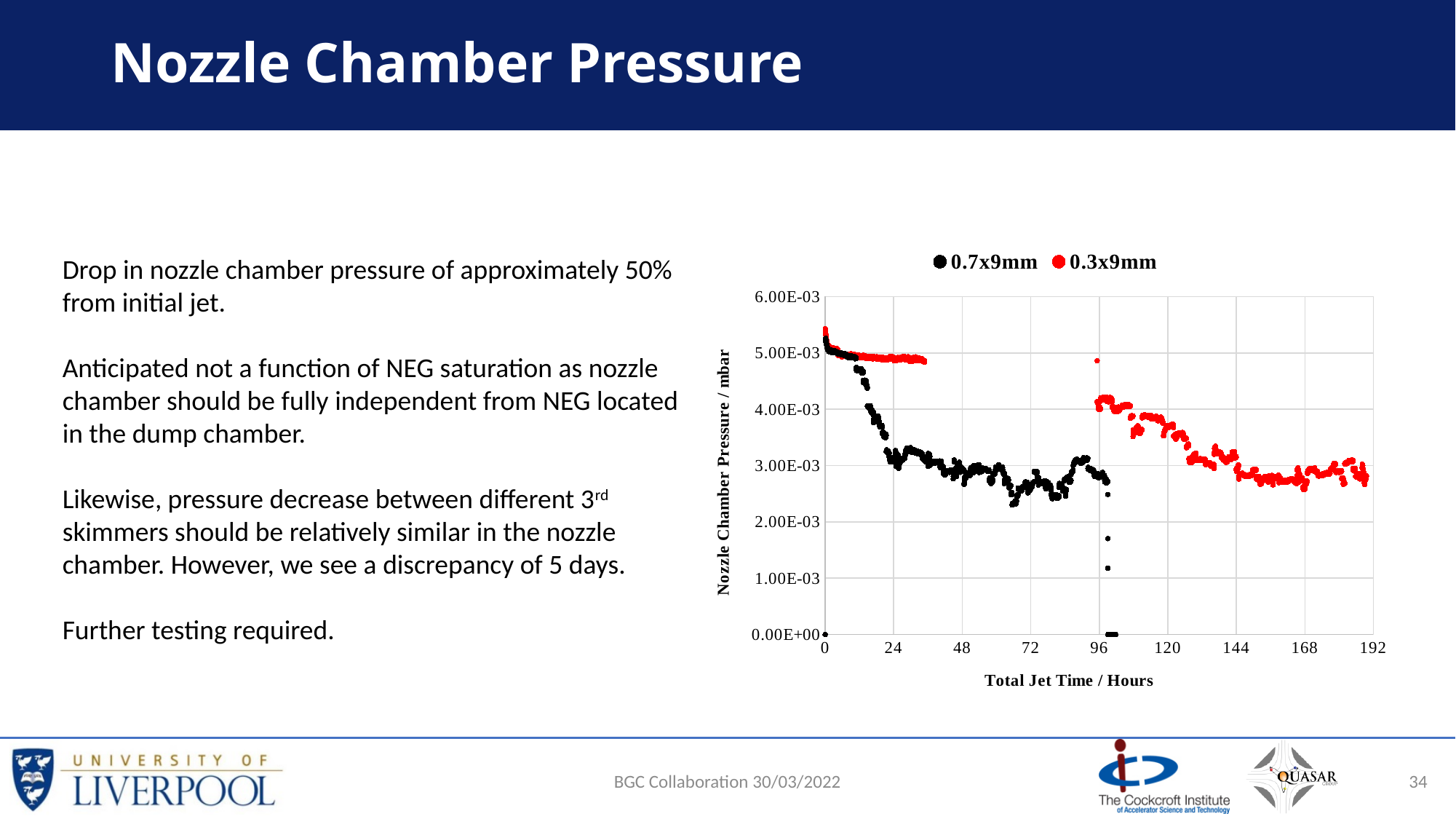
Does the 0.7x9mm nozzle chamber pressure rise or fall between 0 and 72 hours of total jet time? fall What are the two series named in the chart legend? 0.7x9mm and 0.3x9mm Does the 0.3x9mm nozzle chamber pressure rise or fall between 96 and 192 hours of total jet time? fall Is the 0.7x9mm nozzle chamber pressure at around 72 hours greater or less than 3.00E-03 mbar? less Which series extends to the largest total jet time on the chart, 0.7x9mm or 0.3x9mm? 0.3x9mm Is the 0.7x9mm nozzle chamber pressure at around 24 hours greater or less than 2.00E-03 mbar? greater What is the highest value labelled on the chart's y axis? 6.00E-03 What is the title of the chart's x axis? Total Jet Time / Hours How many series does the chart legend list? 2 What kind of chart is shown on the slide? Scatter chart Is the 0.3x9mm nozzle chamber pressure at around 120 hours greater or less than 3.00E-03 mbar? greater